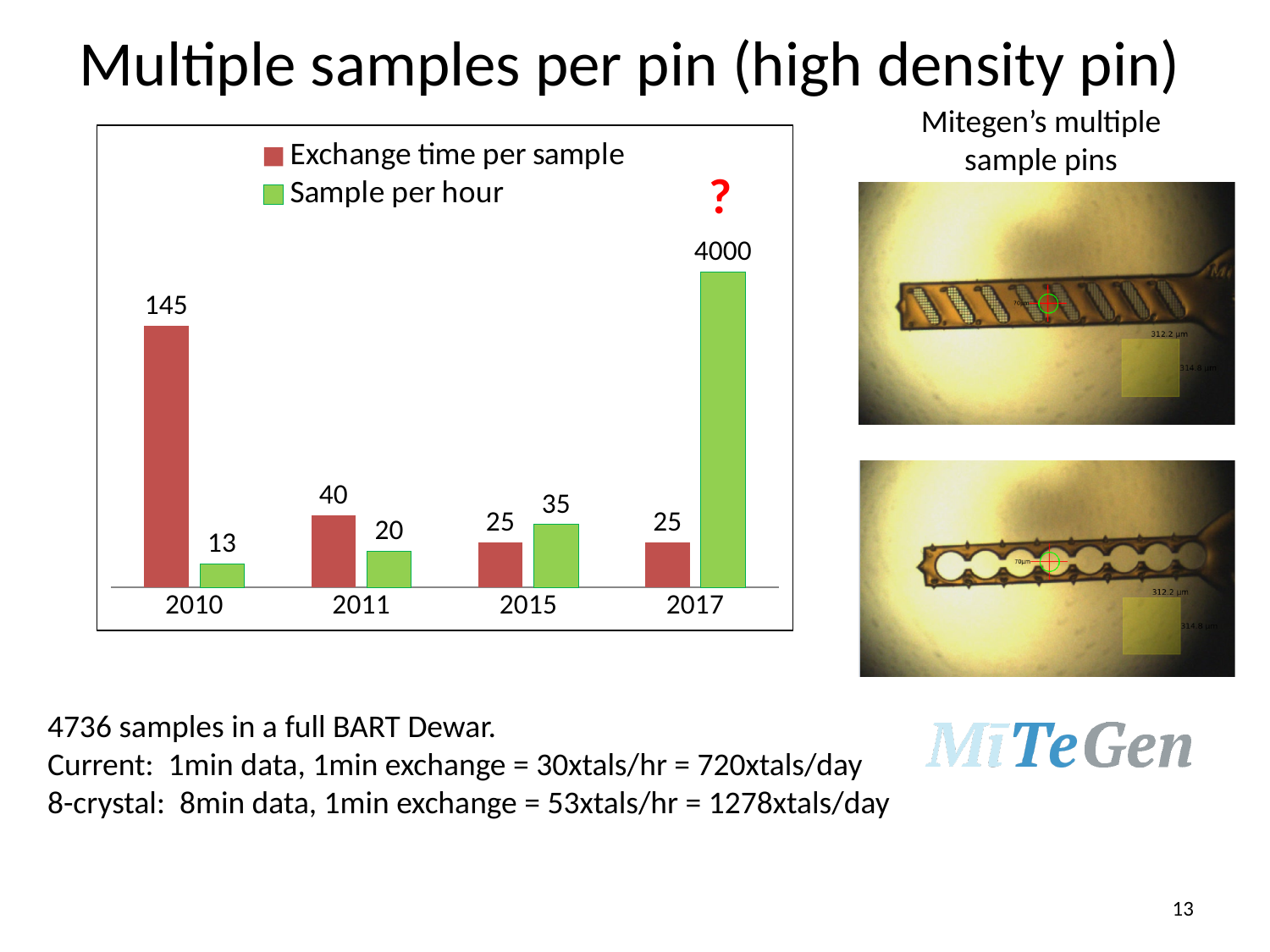
What is the Sample per hour value for 2017? 4000 What is the Exchange time per sample value for 2011? 40 What is the difference between the Exchange time per sample values for 2010 and 2011? 105 How many years are shown on the x axis of the chart? 4 Which is larger in 2015, Exchange time per sample or Sample per hour? Sample per hour Which year has the highest Exchange time per sample? 2010 What is the Sample per hour value for 2015? 35 How many series does the chart legend list? 2 Which year has the lowest Sample per hour? 2010 Does the Exchange time per sample series rise or fall from 2010 to 2015? Fall What is the Exchange time per sample value for 2010? 145 What kind of chart is shown on the slide? Bar chart